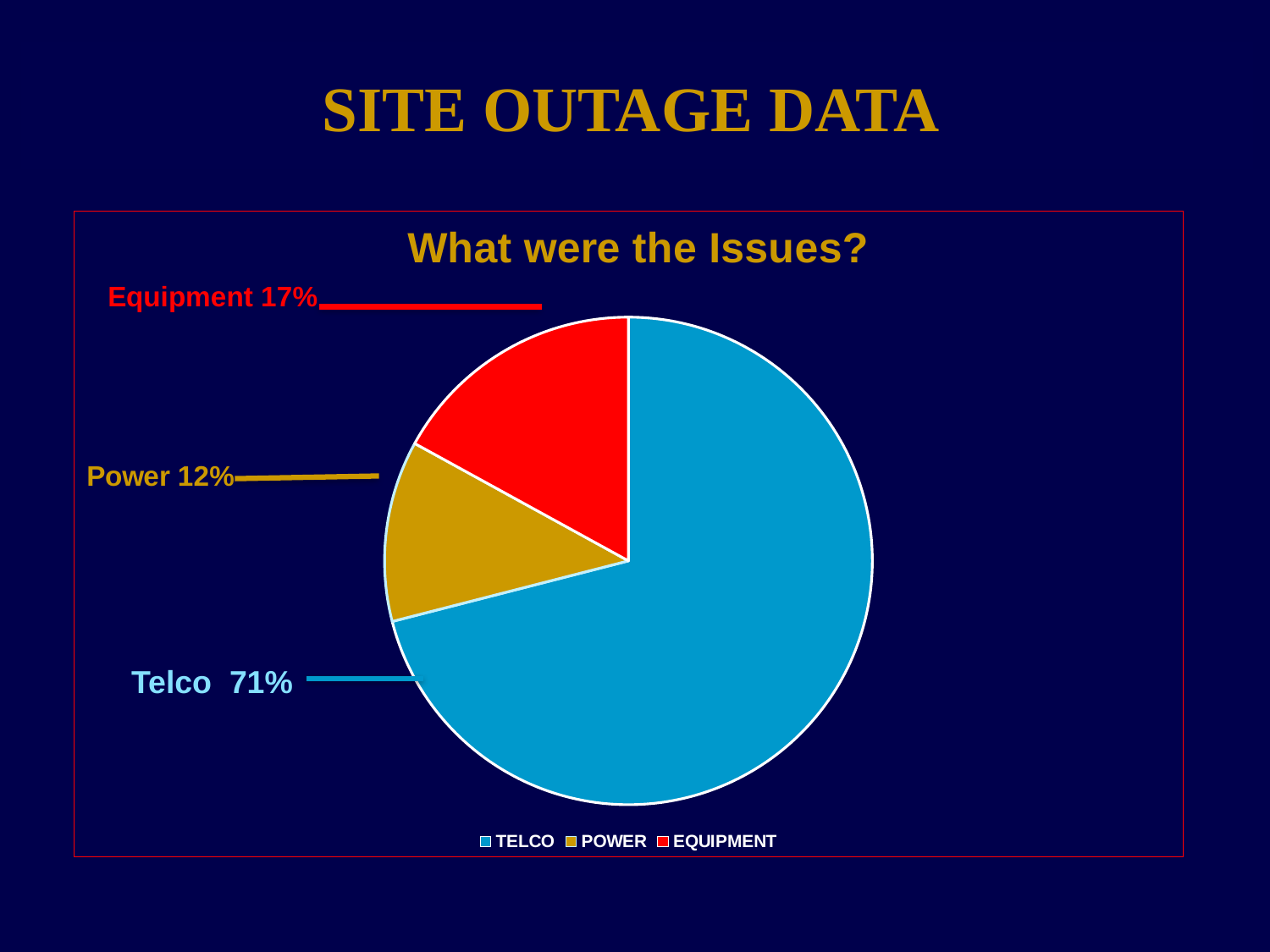
Which category has the smallest slice of the pie? Power Which is larger, the Equipment slice or the Power slice? Equipment How many slices does the pie chart have? 3 What is the difference in percentage points between Equipment and Power? 5 What is the difference in percentage points between Telco and Equipment? 54 What share of the pie does Telco account for? 71% What is the title of the chart? What were the Issues? What kind of chart is shown on the slide? Pie chart What colour is the Telco slice? Blue What share of the pie does Equipment account for? 17% Which category has the largest slice of the pie? Telco What share of the pie does Power account for? 12%